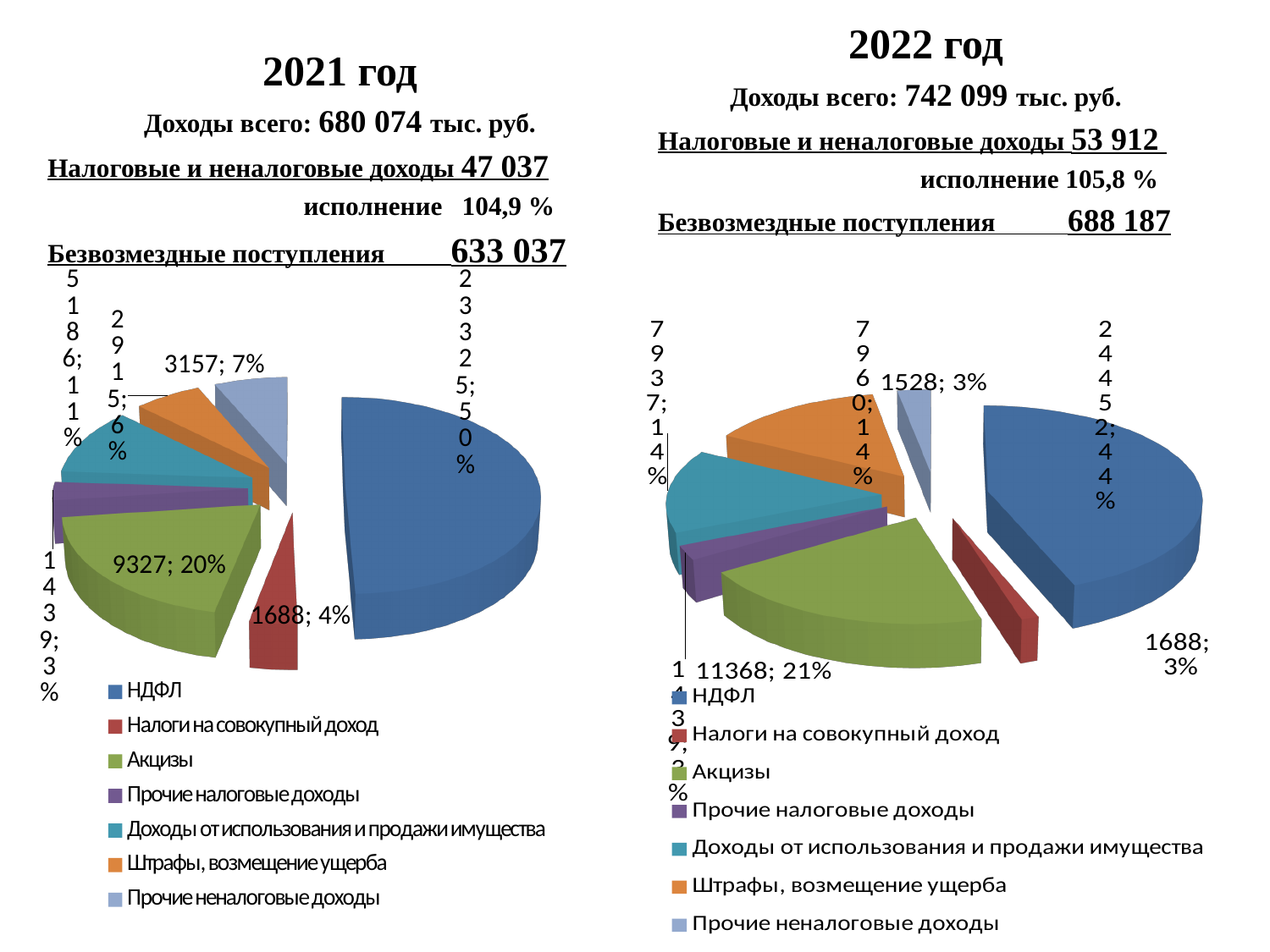
How many categories does the legend of the 2021 год chart list? 7 In the 2022 год chart, what value is shown for Налоги на совокупный доход? 1688 In the 2021 год chart, which category has the largest slice? НДФЛ In the 2022 год chart, what colour represents Акцизы in the legend? Green In the 2022 год chart, which is larger: Акцизы or Прочие неналоговые доходы? Акцизы In the 2021 год chart, what value and share are shown for Прочие неналоговые доходы? 3157; 7% In the 2021 год chart, what is the difference between the values for Акцизы and Налоги на совокупный доход? 7639 In the 2022 год chart, which category has the largest slice? НДФЛ In the 2021 год chart, what value is shown for Акцизы? 9327 In the 2022 год chart, what value and share are shown for Акцизы? 11368; 21% In the 2021 год chart, what share of the pie does Акцизы have? 20% What kind of chart is the 2021 год chart on the left? Pie chart